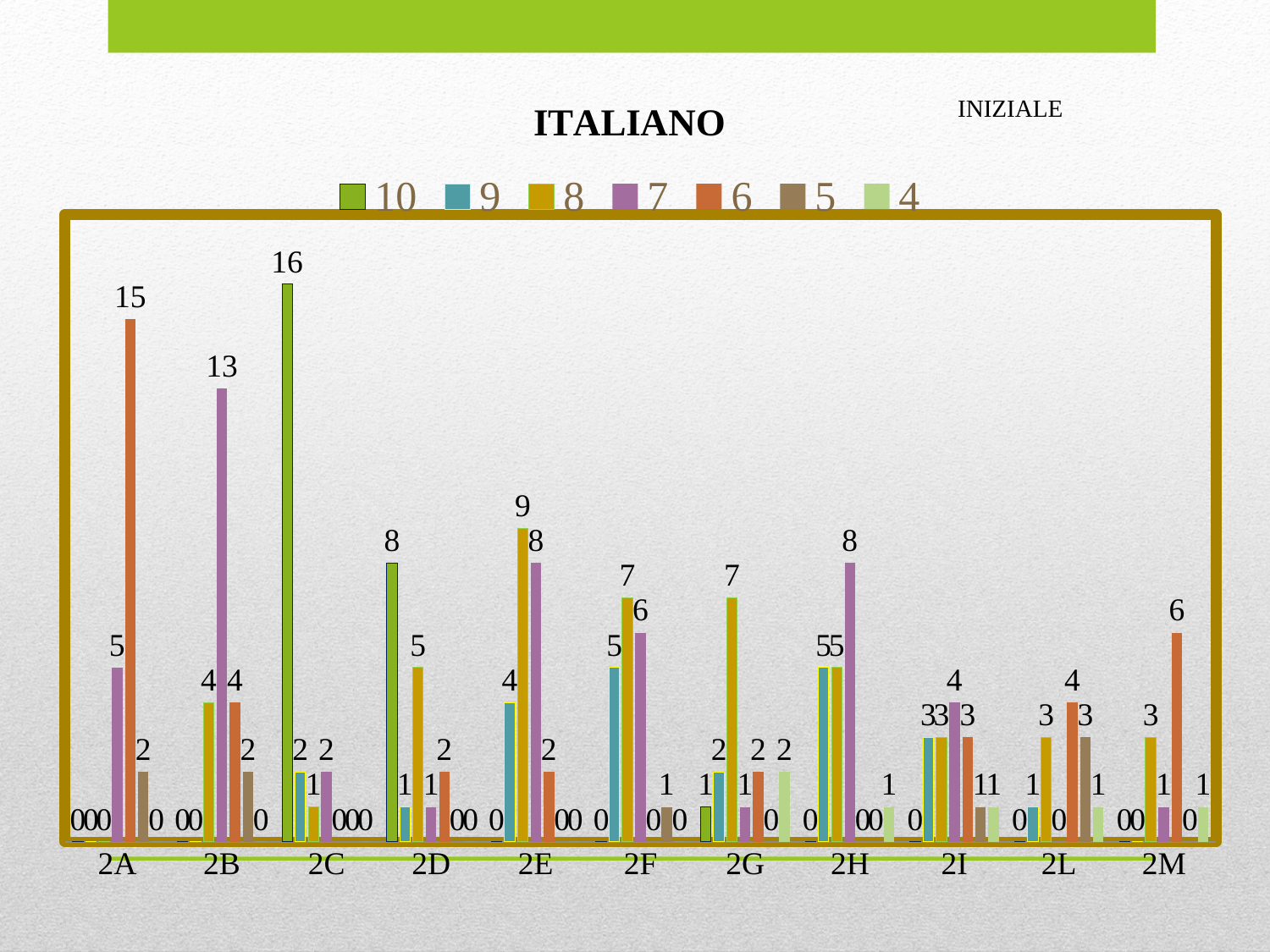
What is the value for series 8 in category 2E? 9 What is the value for series 7 in category 2B? 13 What is the difference between the values for series 6 and series 7 in category 2A? 10 Which category has the highest value for series 10? 2C How many series does the legend list? 7 Which category has the highest value for series 6? 2A What kind of chart is shown on the slide? bar chart What is the value for series 6 in category 2A? 15 How many categories are shown on the x axis? 11 What is the title of the chart? ITALIANO What is the value for series 10 in category 2C? 16 In category 2E, which is larger: the value for series 8 or the value for series 7? series 8